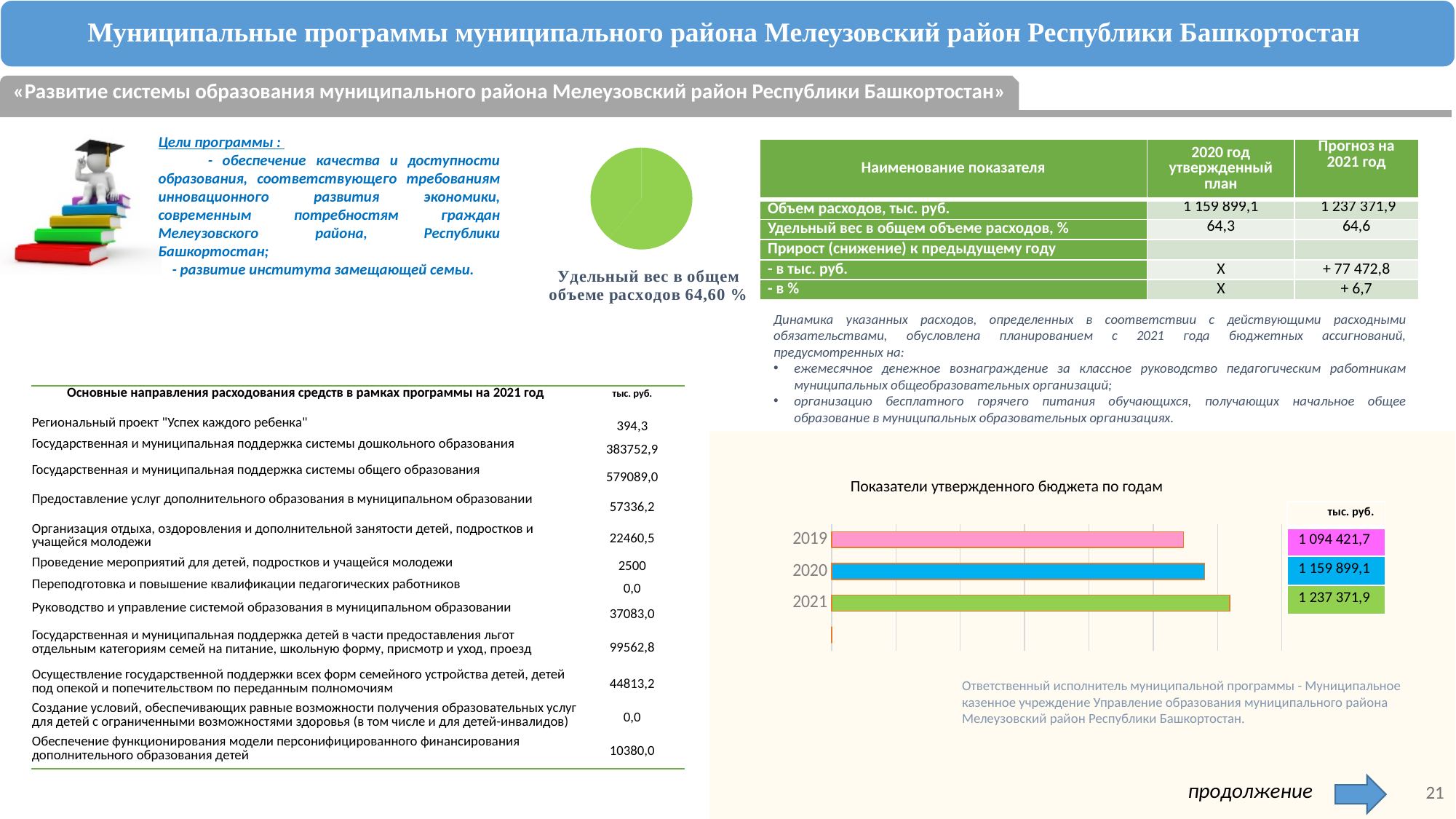
In the chart "Показатели утвержденного бюджета по годам", what is the difference between the values for 2020 and 2019? 65 477,4 In the chart "Показатели утвержденного бюджета по годам", what is the value for 2019? 1 094 421,7 In the chart "Показатели утвержденного бюджета по годам", which is larger, the value for 2019 or the value for 2021? 2021 In the chart "Показатели утвержденного бюджета по годам", what is the value for 2020? 1 159 899,1 In the chart "Показатели утвержденного бюджета по годам", do the values rise or fall from 2019 to 2021? rise What share is shown by the pie chart captioned "Удельный вес в общем объеме расходов"? 64,60 % In the chart "Показатели утвержденного бюджета по годам", which year has the lowest value? 2019 In the chart "Показатели утвержденного бюджета по годам", which year has the highest value? 2021 In the chart "Показатели утвержденного бюджета по годам", what is the value for 2021? 1 237 371,9 In the chart "Показатели утвержденного бюджета по годам", what is the difference between the values for 2021 and 2020? 77 472,8 How many years (bars) are shown in the chart "Показатели утвержденного бюджета по годам"? 3 What kind of chart is the chart titled "Показатели утвержденного бюджета по годам"? bar chart